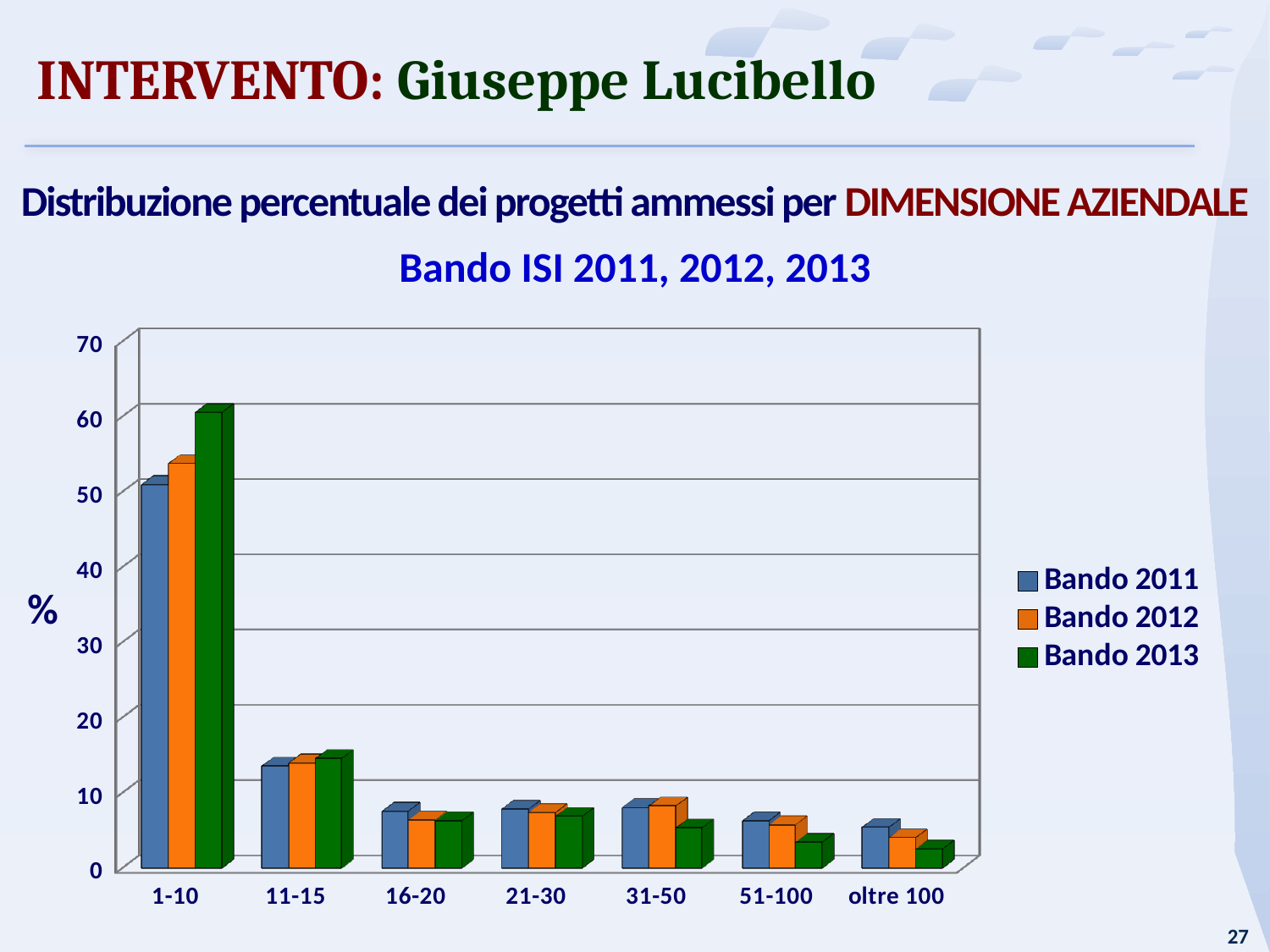
Is the value for Bando 2011 in the 1-10 category greater or less than 60? less Overall, do the Bando 2013 values rise or fall as you move from the 1-10 category to the 'oltre 100' category? fall Is the value for Bando 2013 in the 1-10 category greater or less than 50? greater In the 51-100 category, which is larger: Bando 2011 or Bando 2013? Bando 2011 What label is shown on the vertical axis of the chart? % How many company-size categories are shown on the x axis? 7 Which category has the highest value for Bando 2013? 1-10 What kind of chart is shown on the slide? bar chart Is the value for Bando 2013 in the 'oltre 100' category greater or less than 10? less How many series does the legend list? 3 In the 1-10 category, which is larger: Bando 2011 or Bando 2013? Bando 2013